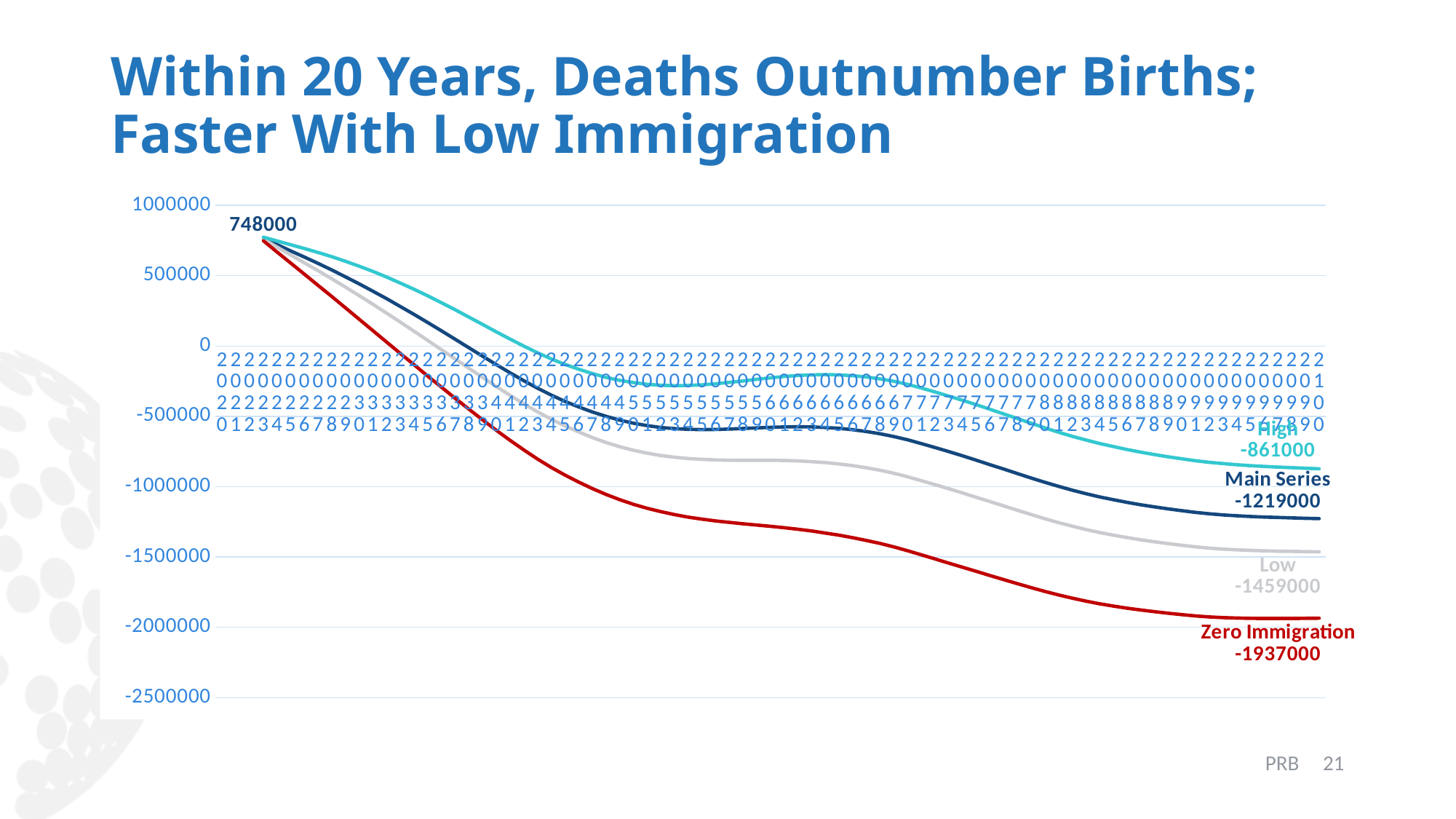
What is the final value of the Main Series? -1219000 What is the difference between the final values of the Main Series and the Low series? 240000 Do the values rise or fall along the x axis? fall What is the difference between the final values of the High series and the Zero Immigration series? 1076000 How many series are plotted on the chart? 4 What is the starting value shown at the beginning of the lines in 2020? 748000 What kind of chart is shown on the slide? line chart What is the final value of the High series? -861000 What is the final value of the Low series? -1459000 Which series ends at the lowest value? Zero Immigration What is the final value of the Zero Immigration series? -1937000 Which series ends at the highest value? High